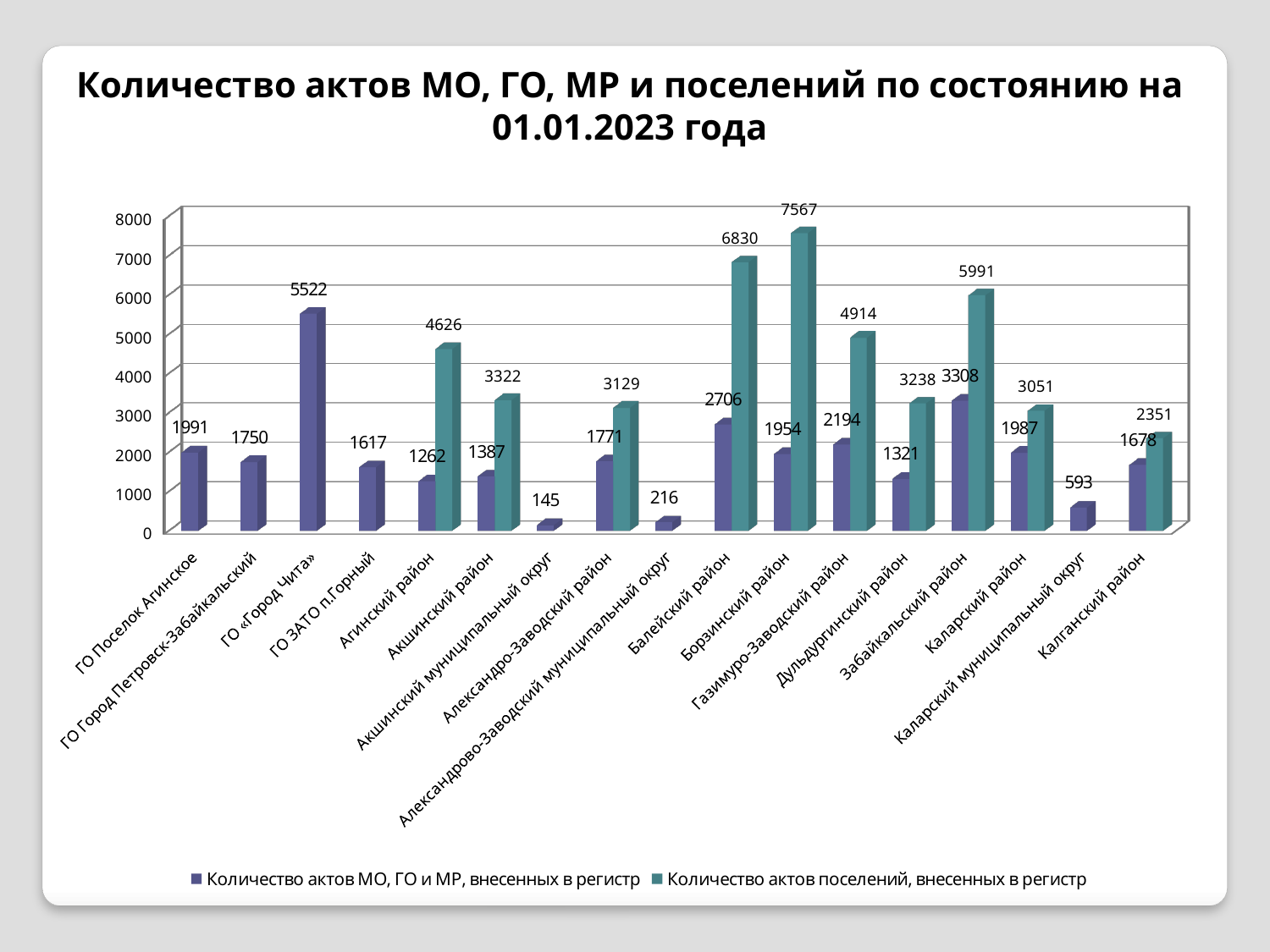
What is the value of 'Количество актов поселений, внесенных в регистр' for Борзинский район? 7567 Which category has the lowest value for 'Количество актов МО, ГО и МР, внесенных в регистр'? Акшинский муниципальный округ What is the value of 'Количество актов МО, ГО и МР, внесенных в регистр' for ГО «Город Чита»? 5522 How many series does the legend list? 2 Which is larger: the 'Количество актов поселений' value for Агинский район or for Газимуро-Заводский район? Газимуро-Заводский район What is the difference between the two series values for Балейский район? 4124 Which category has the highest value for 'Количество актов поселений, внесенных в регистр'? Борзинский район What is the title of the chart? Количество актов МО, ГО, МР и поселений по состоянию на 01.01.2023 года What kind of chart is shown on the slide? Bar chart What is the value of 'Количество актов МО, ГО и МР, внесенных в регистр' for Каларский муниципальный округ? 593 Is the value for 'Количество актов поселений, внесенных в регистр' for Забайкальский район greater or less than 5000? greater How many categories are shown on the x axis? 17